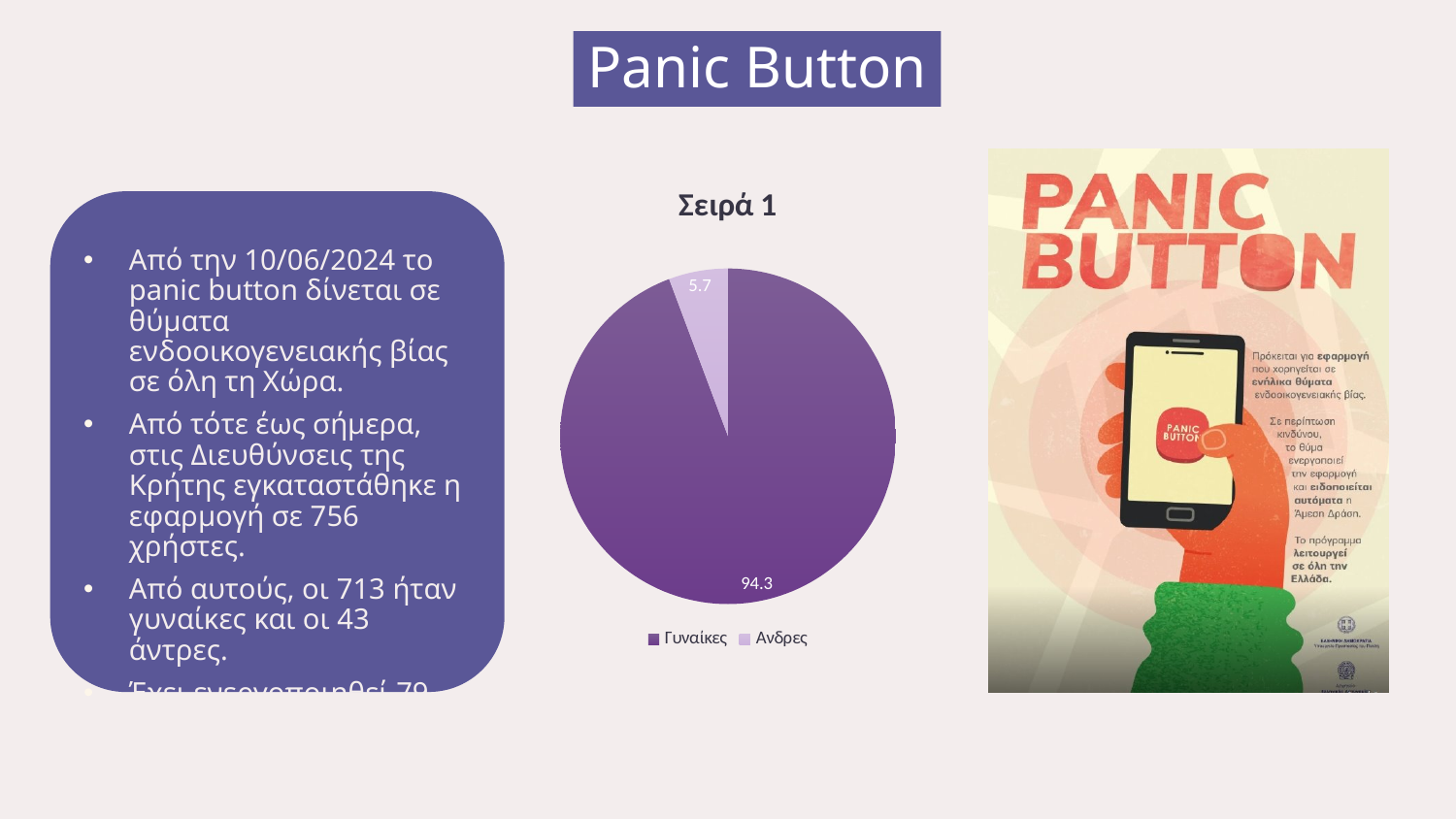
Which is larger in the pie chart, the value for Γυναίκες or the value for Άνδρες? Γυναίκες How many entries does the legend of the pie chart list? 2 What are the two legend entries of the pie chart? Γυναίκες and Άνδρες What value is shown for Γυναίκες in the pie chart? 94.3 Which category has the smallest slice in the pie chart? Άνδρες How many slices does the pie chart have? 2 What kind of chart is shown on the slide? pie chart Which category has the largest slice in the pie chart? Γυναίκες What is the title of the pie chart? Σειρά 1 What is the difference between the values for Γυναίκες and Άνδρες in the pie chart? 88.6 What value is shown for Άνδρες in the pie chart? 5.7